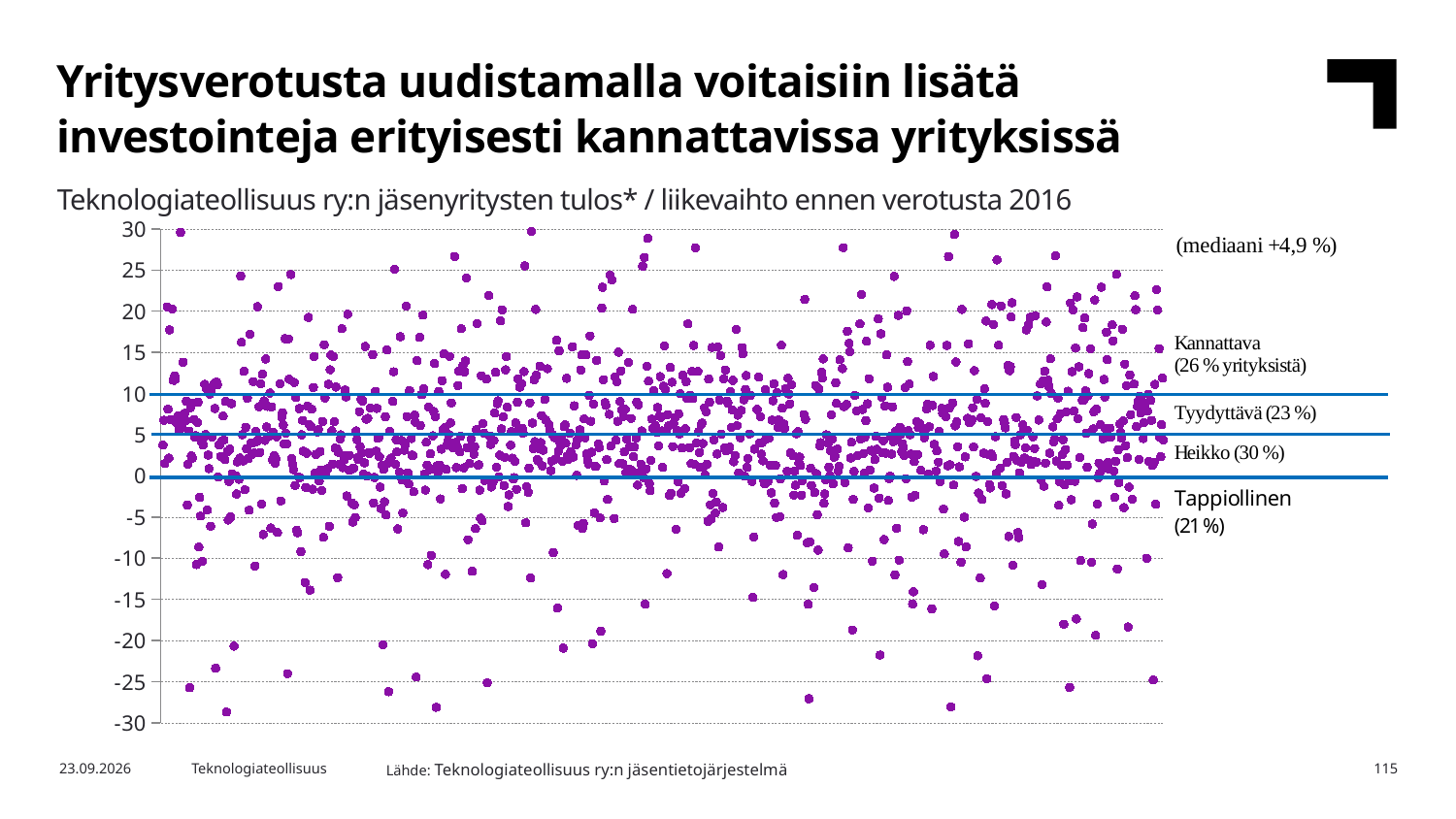
What kind of chart is shown on the slide? Scatter plot What share of companies falls into the Tyydyttävä category? 23 % What is the difference in percentage points between the Heikko share and the Tappiollinen share? 9 What share of companies falls into the Kannattava category? 26 % Which category has the smallest share of companies? Tappiollinen Which category has the largest share of companies? Heikko What share of companies falls into the Tappiollinen category? 21 % Which category has a larger share of companies, Kannattava or Tyydyttävä? Kannattava What is the highest value shown on the vertical axis? 30 What share of companies falls into the Heikko category? 30 % Is the median value shown on the chart greater or less than 5? less What is the median value (mediaani) stated on the chart? +4,9 %